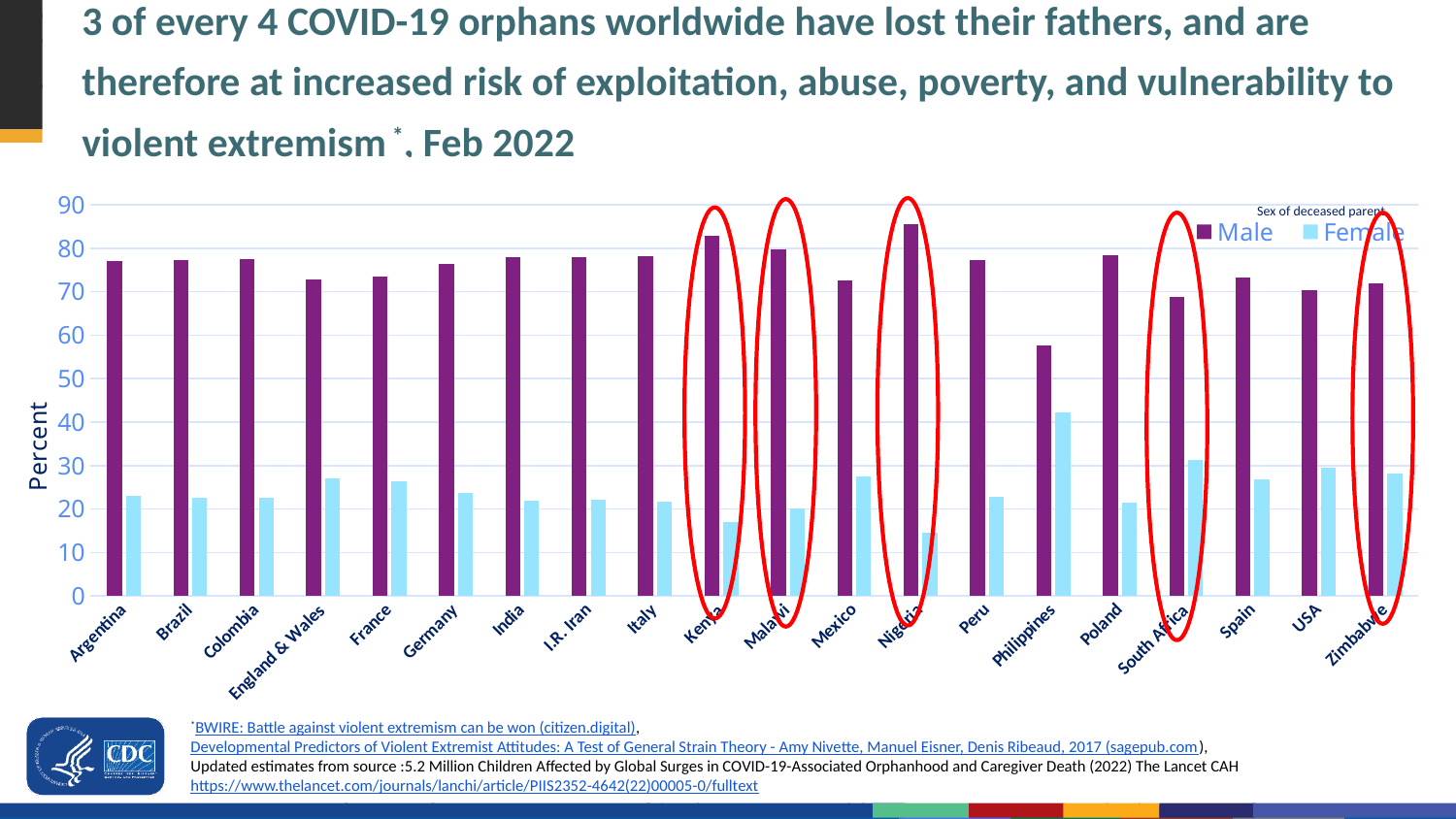
Which country has the highest Female value? Philippines What is the label on the y axis of the chart? Percent How many series does the legend list? 2 What kind of chart is shown on the slide? bar chart Is the Female value for Nigeria greater or less than 20? less Which country has the lowest Male value? Philippines Is the Male value for Philippines greater or less than 60? less Is the Male value for Kenya greater or less than 80? greater Which is larger, the Male value for Poland or the Male value for Philippines? Poland How many countries are shown on the x axis of the chart? 20 What is the title of the chart's legend? Sex of deceased parent